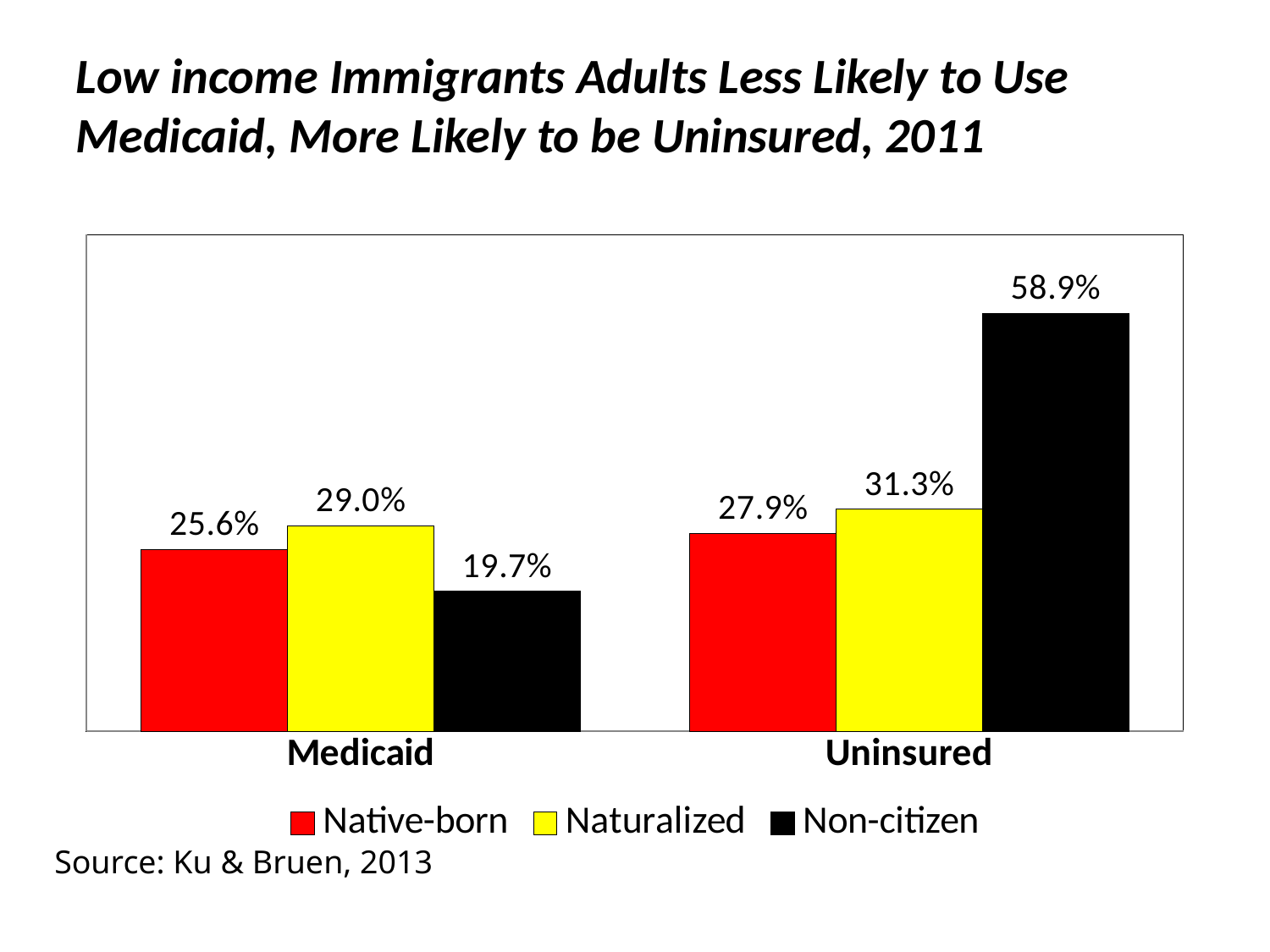
What is the Uninsured value for Naturalized adults? 31.3% What is the difference between the Medicaid rates for Naturalized and Non-citizen adults? 9.3% How many series does the legend list? 3 Which group has the lowest Medicaid rate? Non-citizen What kind of chart is shown on the slide? Bar chart Which is larger: the Medicaid rate for Naturalized adults or the Uninsured rate for Native-born adults? Medicaid rate for Naturalized adults Which group has the highest Uninsured rate? Non-citizen What is the difference between the Uninsured rates for Non-citizen and Native-born adults? 31.0% What is the Medicaid value for Native-born adults? 25.6% How many categories are shown on the x axis? 2 What is the Medicaid value for Non-citizen adults? 19.7% Which colour represents the Naturalized series? Yellow